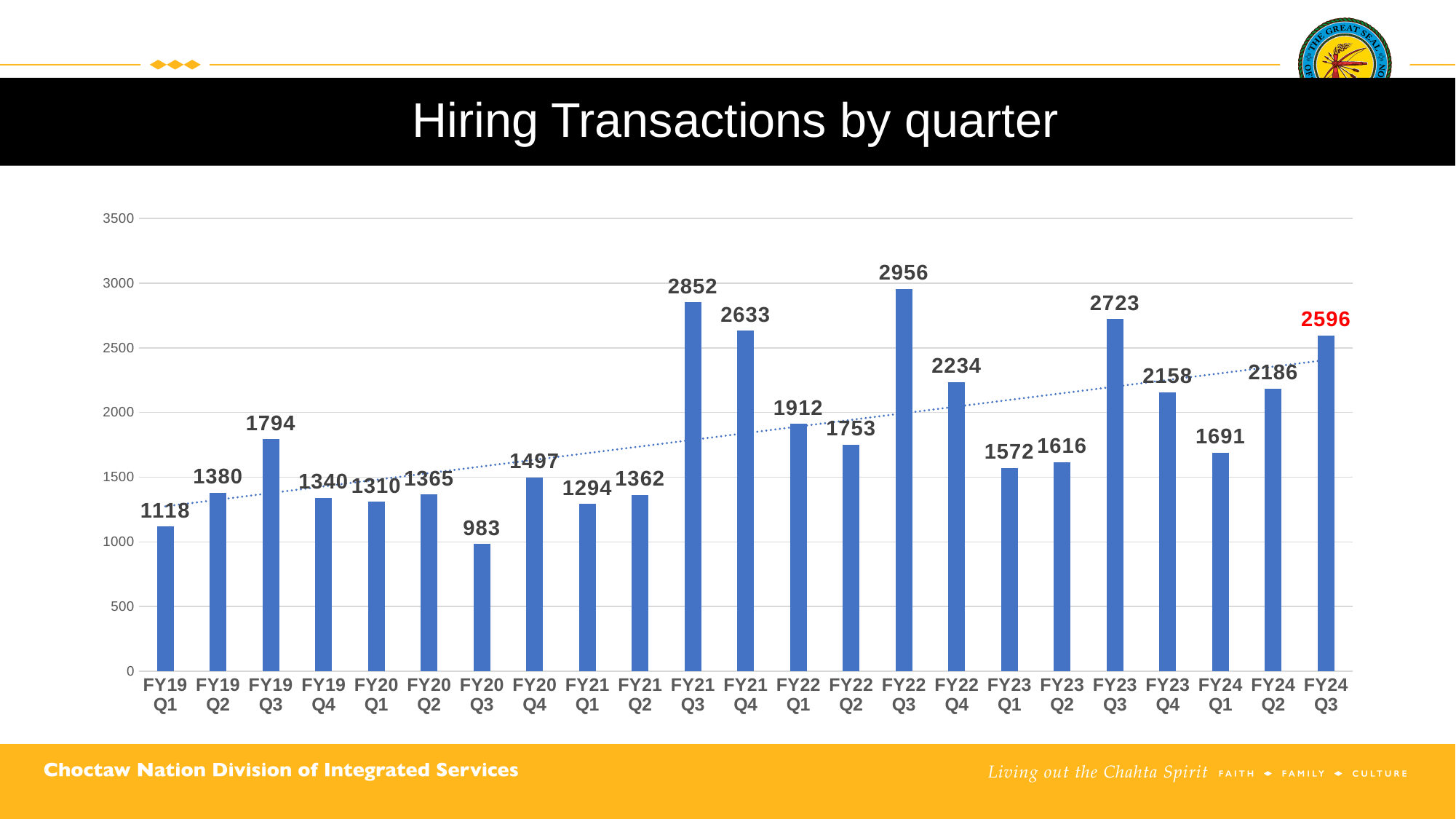
Does the dotted trend line rise or fall from left to right? rise What is the value for FY22 Q4? 2234 What is the value for FY20 Q3? 983 What is the value for FY24 Q3? 2596 How many quarters are shown on the x axis? 23 Which quarter has the lowest number of hiring transactions? FY20 Q3 What kind of chart is shown on the slide? bar chart Which quarter has the highest number of hiring transactions? FY22 Q3 What is the difference between the values for FY24 Q3 and FY24 Q2? 410 Is the value for FY23 Q1 greater or less than 2000? less What is the difference between the values for FY22 Q3 and FY21 Q3? 104 Which is larger, the value for FY23 Q3 or the value for FY21 Q4? FY23 Q3